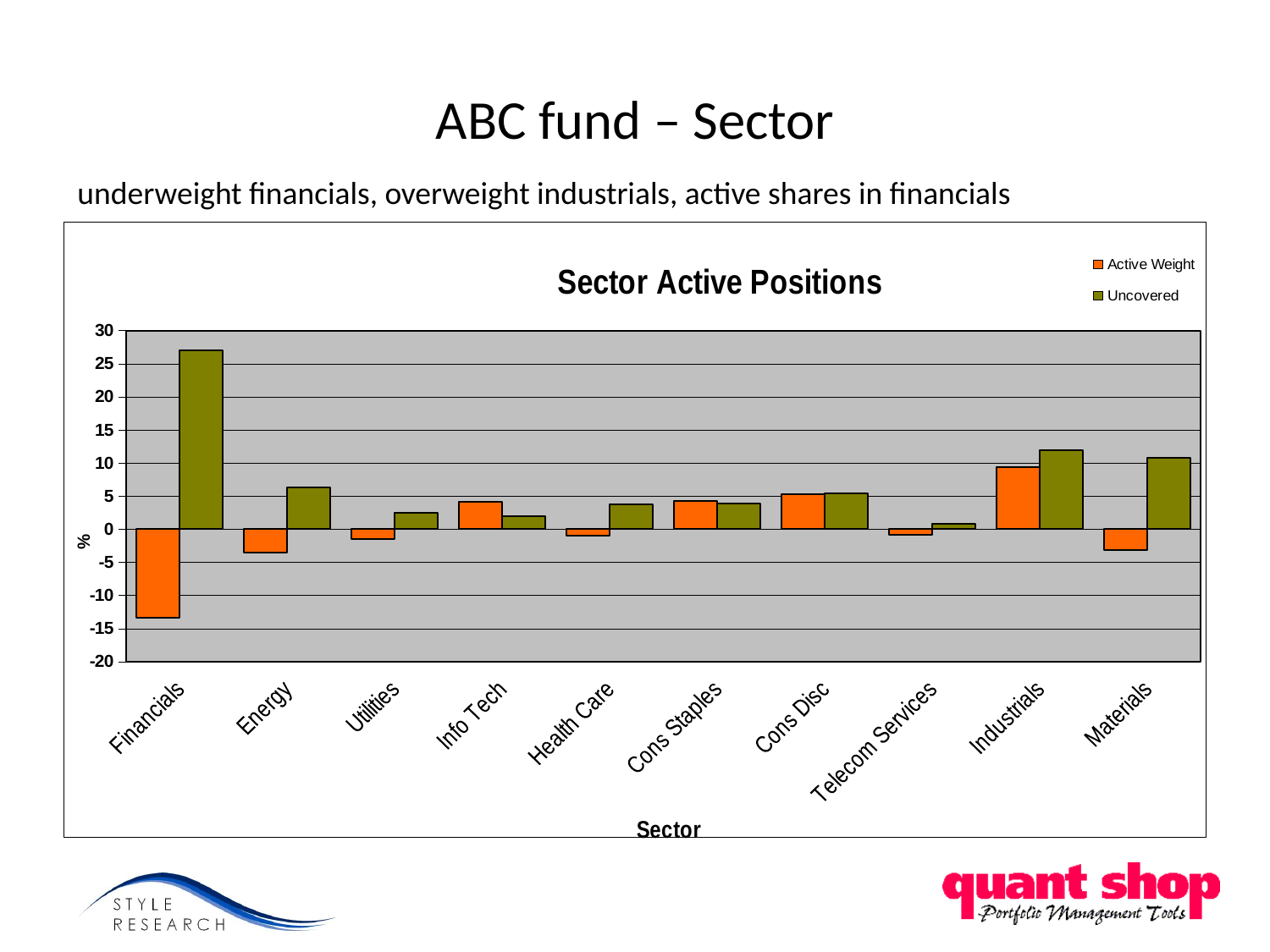
Which sector has the highest Active Weight value? Industrials Which sector has the highest Uncovered value? Financials Which has the larger Uncovered value, Financials or Industrials? Financials Which has the larger Active Weight value, Industrials or Cons Disc? Industrials What is the title of the chart? Sector Active Positions Is the Active Weight value for Financials greater or less than -10? less How many sectors are shown on the x axis of the chart? 10 Is the Uncovered value for Financials greater or less than 25? greater Is the Active Weight value for Industrials greater or less than 5? greater Which sector has the lowest Active Weight value? Financials How many series does the chart's legend list? 2 What kind of chart is shown on the slide? bar chart